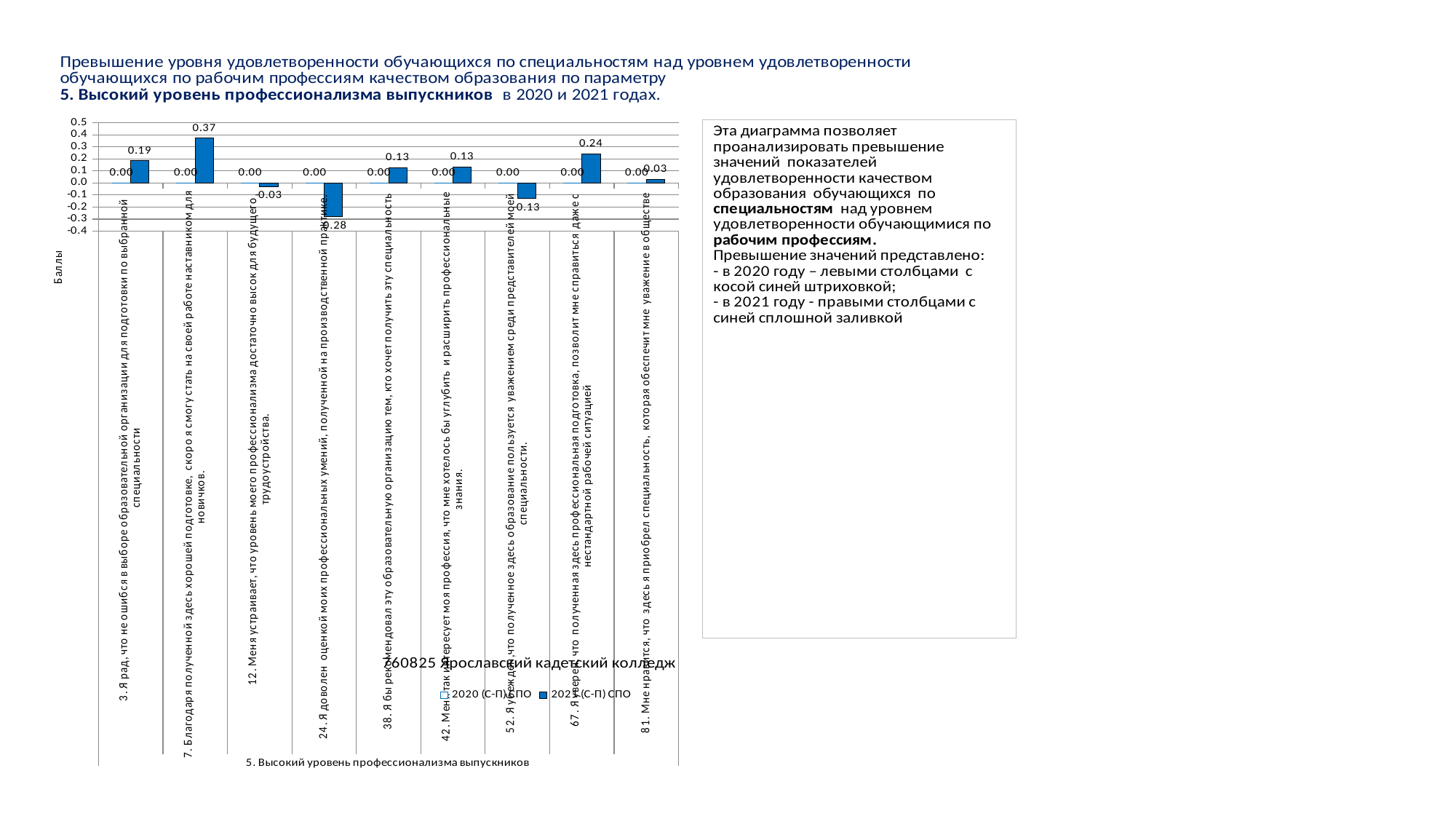
How many series does the chart legend list? 2 Which statement has the lowest 2021 (С-П) СПО value? 24. Я доволен оценкой моих профессиональных умений, полученной на производственной практике. How many categories (statements) are plotted along the x axis of the chart? 9 Which statement has the highest 2021 (С-П) СПО value? 7. Благодаря полученной здесь хорошей подготовке, скоро я смогу стать на своей работе наставником для новичков. What is the 2021 (С-П) СПО value for statement 24 (Я доволен оценкой моих профессиональных умений...)? -0.28 What type of chart is shown on the slide? bar chart What is the 2021 (С-П) СПО value for statement 67 (Я уверен, что полученная здесь профессиональная подготовка...)? 0.24 What is the title of the chart's x axis category group shown at the bottom? 5. Высокий уровень профессионализма выпускников What is the 2021 (С-П) СПО value for statement 7 (Благодаря полученной здесь хорошей подготовке...)? 0.37 What is the difference between the 2021 (С-П) СПО values for statement 7 and statement 3? 0.18 Which is larger: the 2021 (С-П) СПО value for statement 67 or for statement 81? statement 67 What is the 2020 (С-П) СПО value for statement 3 (Я рад, что не ошибся в выборе образовательной организации...)? 0.00